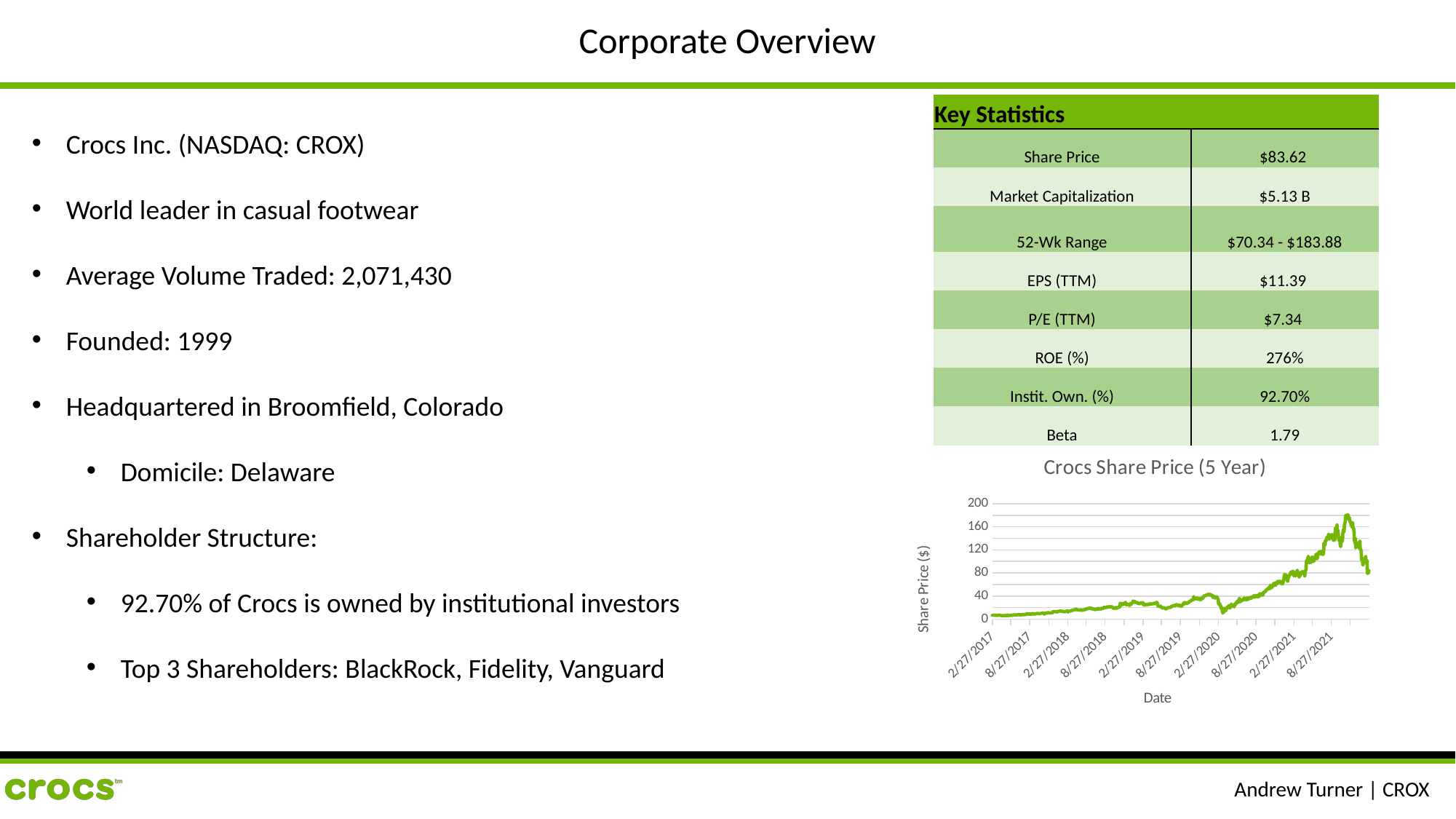
What is the label of the vertical axis of the share price chart? Share Price ($) Is the highest share price reached on the chart greater or less than 160? greater Is the share price at 2/27/2017 greater or less than 40? less Is the share price at 8/27/2021 greater or less than 80? greater What kind of chart is shown under the title "Crocs Share Price (5 Year)"? line chart Which is higher on the chart, the share price at 2/27/2018 or at 2/27/2021? 2/27/2021 What is the title of the chart on the slide? Crocs Share Price (5 Year) Overall, does the share price rise or fall from 2/27/2017 to the end of the chart? rise What is the highest value shown on the vertical axis of the share price chart? 200 How many date labels are shown along the x axis of the share price chart? 10